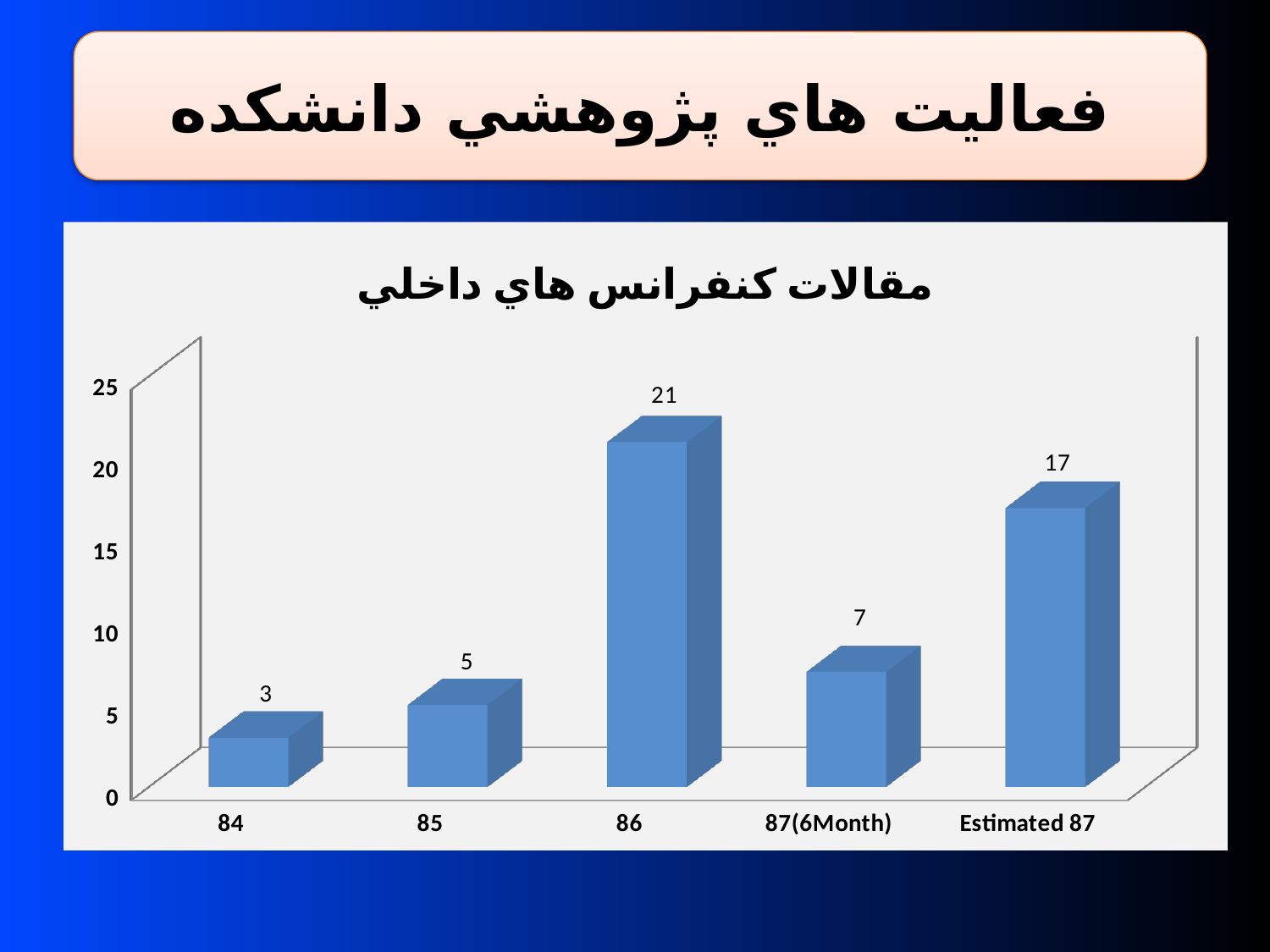
Which category has the highest value? 86 What is the value for 84? 3 What is the difference between the values for 86 and Estimated 87? 4 Which category has the lowest value? 84 What is the difference between the values for 85 and 84? 2 How many categories are shown on the x axis? 5 What is the value for 87(6Month)? 7 Which is larger, the value for 85 or the value for 87(6Month)? 87(6Month) What kind of chart is this? bar chart What is the title of the chart? مقالات کنفرانس هاي داخلي What is the value for Estimated 87? 17 What is the value for 86? 21